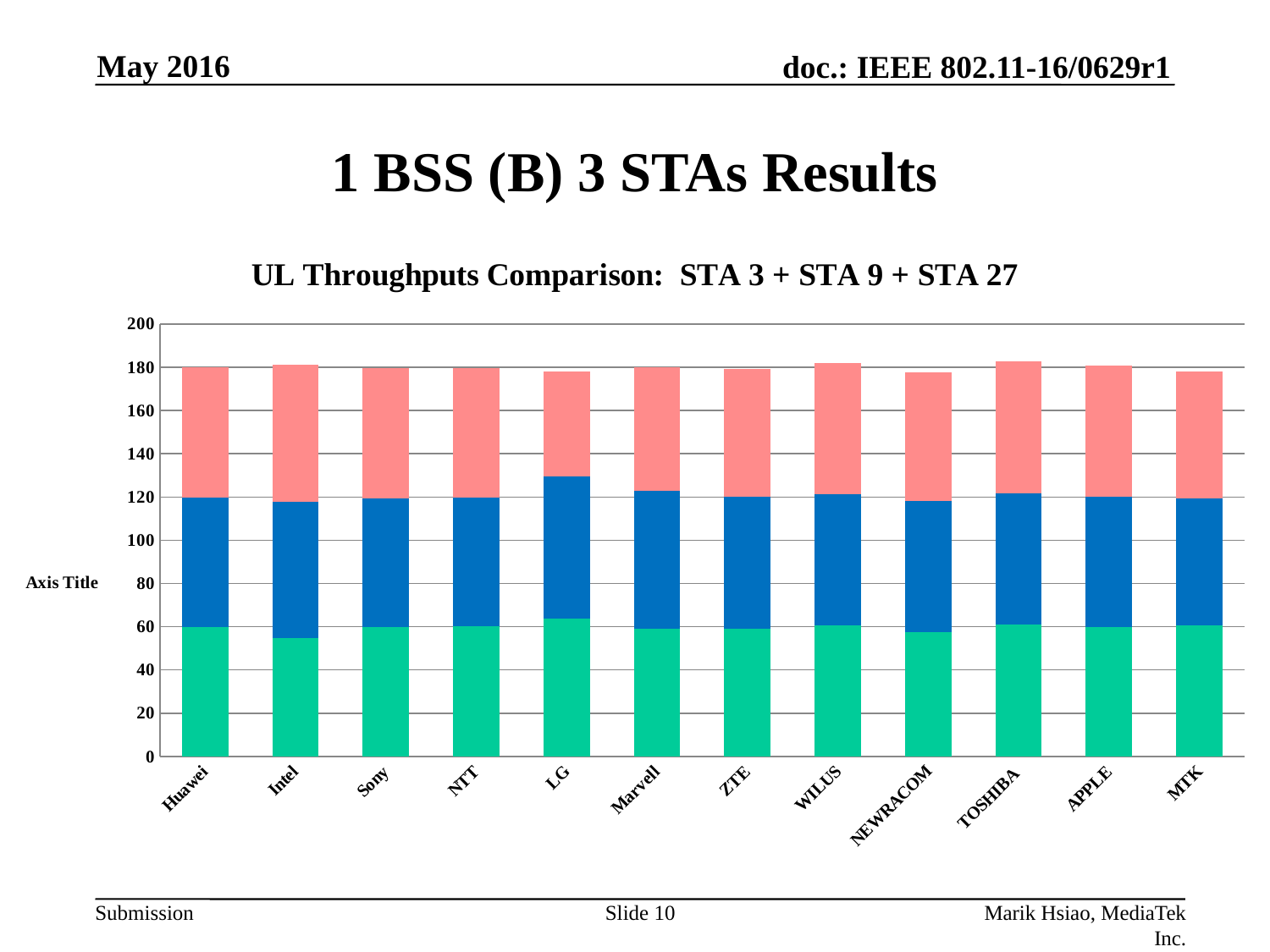
How many companies (categories) are shown along the x axis of the chart? 12 What kind of chart is shown on the slide? Stacked bar chart Which company has the largest bottom (green) segment? LG Is the total stacked value for Sony greater or less than 140? greater What is the title of the chart? UL Throughputs Comparison: STA 3 + STA 9 + STA 27 Is the top of the middle (blue) segment for LG greater or less than 120? greater Is the total stacked value for MTK greater or less than 200? less What is the label shown on the vertical axis of the chart? Axis Title Which is larger, the bottom (green) segment for LG or for Intel? LG Which company's middle (blue) segment reaches the highest point on the axis? LG